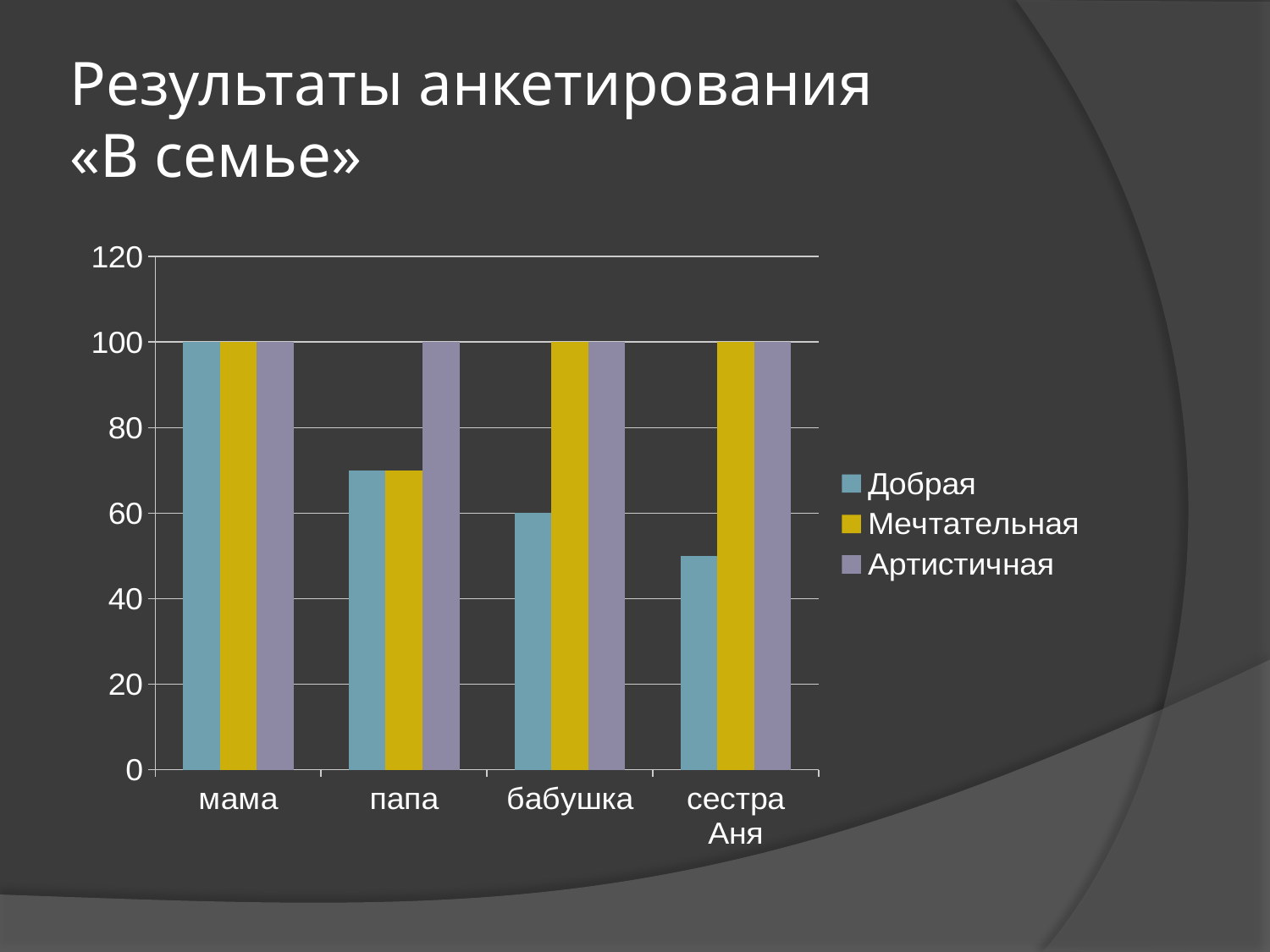
What kind of chart is shown on the slide? bar chart What is the value of Добрая for бабушка? 60 What is the value of Артистичная for папа? 100 How many series does the legend list? 3 Do the Добрая values rise or fall from мама to сестра Аня along the x axis? fall How many categories are shown on the x axis? 4 Is the value of Добрая for папа greater or less than 80? less What is the difference between the Добрая value for мама and the Добрая value for бабушка? 40 Which is larger, the Добрая value for папа or for бабушка? папа Is the value of Добрая for сестра Аня greater or less than 60? less What is the value of Добрая for мама? 100 Which category has the lowest value for Добрая? сестра Аня